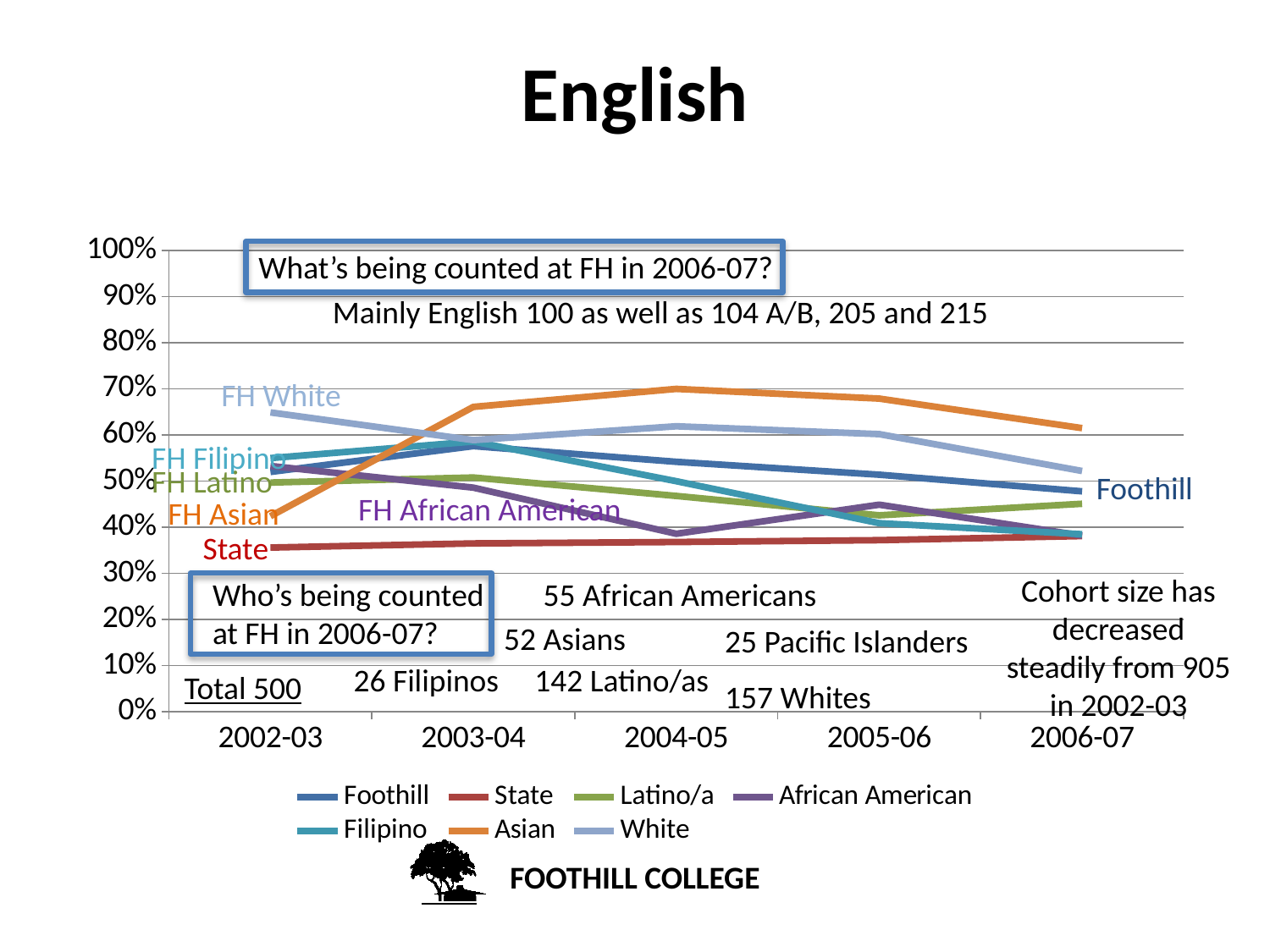
Which series has the highest value in 2002-03? White What is the title of the slide? English Which series has the lowest value in 2002-03? State How many academic years are shown on the x axis? 5 Is the value for Asian in 2004-05 greater or less than 60%? greater In 2002-03, which is larger: the value for White or the value for Foothill? White Is the value for State in 2002-03 greater or less than 40%? less What kind of chart is shown on the slide? line chart Does the State series rise or fall from 2002-03 to 2006-07? rise Which series has the highest value in 2004-05? Asian How many series does the legend list? 7 Is the value for White in 2002-03 greater or less than 60%? greater